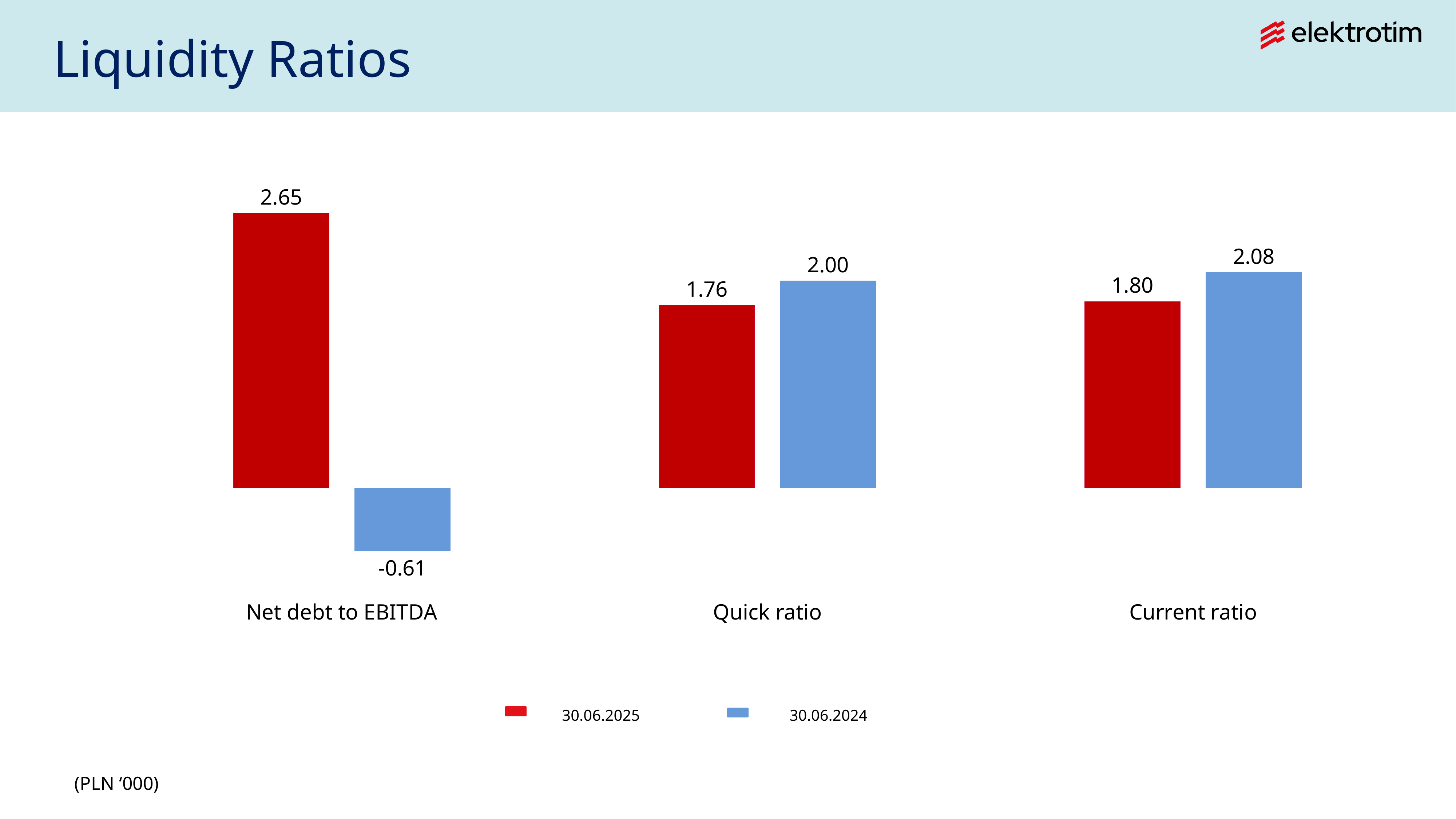
What is the difference between the Current ratio for 30.06.2024 and for 30.06.2025? 0.28 Which category has the highest value for the 30.06.2025 series? Net debt to EBITDA What is the Net debt to EBITDA value for 30.06.2024? -0.61 What kind of chart is shown on the slide? Bar chart Which is larger, the Quick ratio for 30.06.2025 or for 30.06.2024? 30.06.2024 What is the Quick ratio for 30.06.2025? 1.76 What is the Current ratio for 30.06.2024? 2.08 Which category has the lowest value for the 30.06.2024 series? Net debt to EBITDA How many categories are shown on the x axis? 3 What is the difference between the Quick ratio for 30.06.2024 and for 30.06.2025? 0.24 What is the Net debt to EBITDA value for 30.06.2025? 2.65 How many series does the legend list? 2